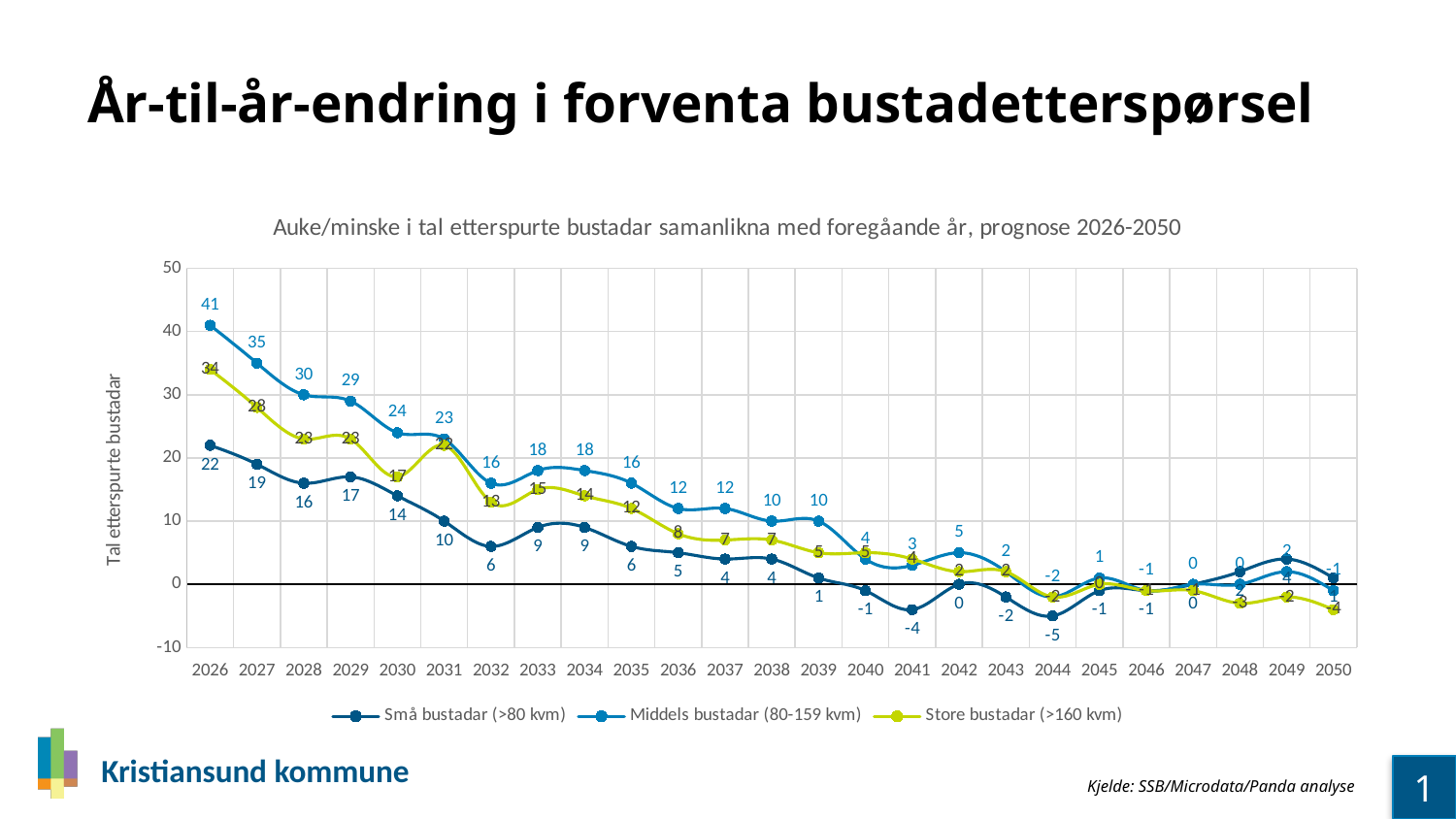
How many series does the legend list? 3 What is the value for Middels bustadar (80-159 kvm) in 2027? 35 In 2030, which is larger: Middels bustadar (80-159 kvm) or Store bustadar (>160 kvm)? Middels bustadar (80-159 kvm) In which year does Middels bustadar (80-159 kvm) reach its highest value? 2026 How many years are plotted along the x axis? 25 Do the values for Middels bustadar (80-159 kvm) generally rise or fall from 2026 to 2050? fall In which year does Små bustadar (>80 kvm) reach its lowest value? 2044 What is the value for Middels bustadar (80-159 kvm) in 2026? 41 What is the difference between Middels bustadar (80-159 kvm) and Små bustadar (>80 kvm) in 2026? 19 What is the value for Store bustadar (>160 kvm) in 2026? 34 What kind of chart is shown on the slide? line chart What is the value for Små bustadar (>80 kvm) in 2026? 22